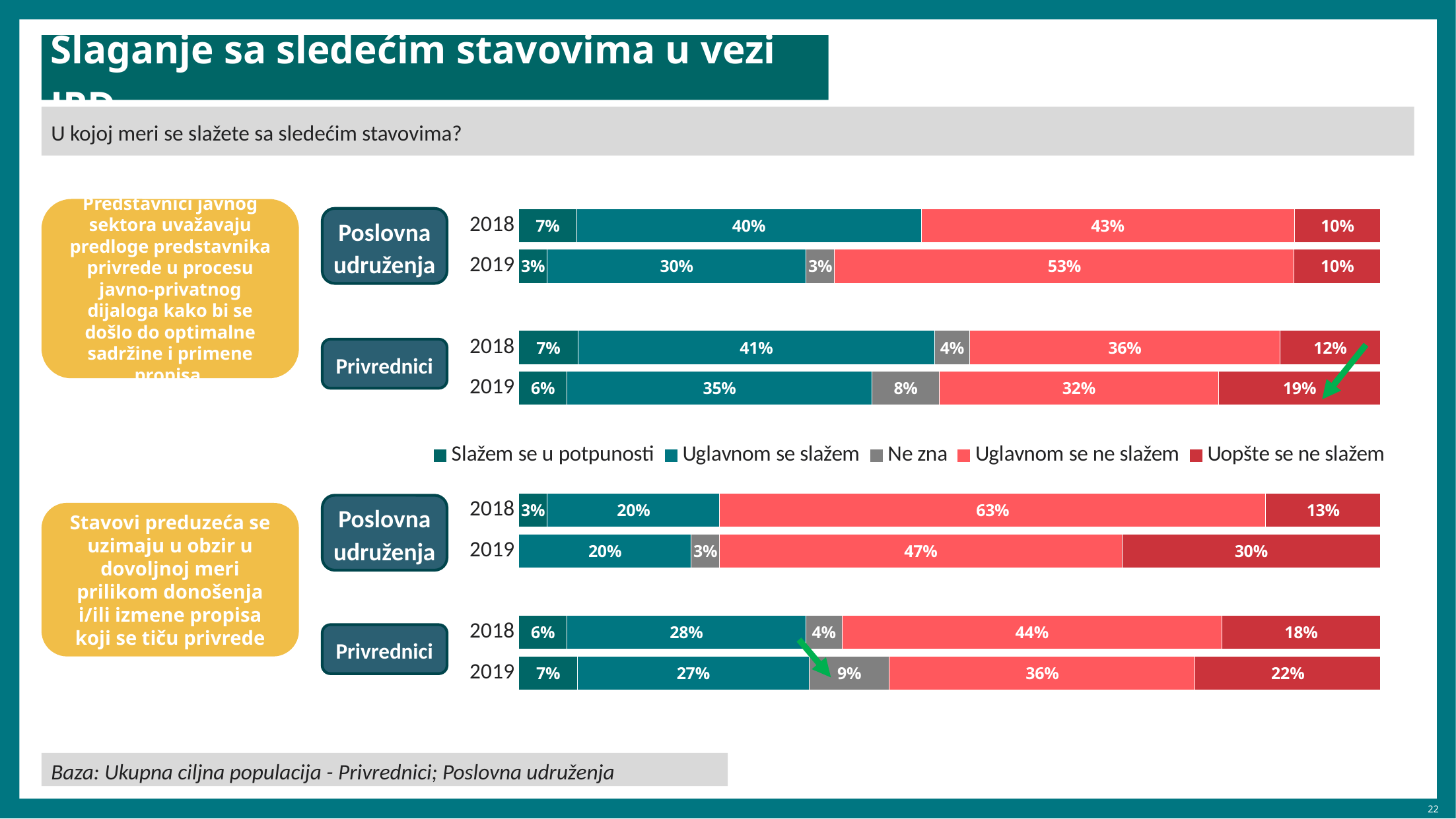
In the bottom chart (Stavovi preduzeća...), what percentage of Poslovna udruženja in 2019 answered 'Uopšte se ne slažem'? 30% In the bottom chart (Stavovi preduzeća...), which year had the larger 'Uopšte se ne slažem' share for Poslovna udruženja, 2018 or 2019? 2019 In the top chart (Predstavnici javnog sektora...), by how many percentage points did the 'Uopšte se ne slažem' share for Privrednici change from 2018 to 2019? 7 percentage points In the bottom chart (Stavovi preduzeća...), what percentage of Privrednici in 2019 answered 'Ne zna'? 9% How many bars are shown in the top chart (Predstavnici javnog sektora...)? 4 In the bottom chart (Stavovi preduzeća...), what percentage of Poslovna udruženja in 2018 answered 'Uglavnom se ne slažem'? 63% In the top chart (Predstavnici javnog sektora...), what percentage of Poslovna udruženja in 2019 answered 'Uglavnom se ne slažem'? 53% What type of chart is used on this slide? Stacked bar chart In the bottom chart (Stavovi preduzeća...), which response category has the largest share for Privrednici in 2018? Uglavnom se ne slažem In the top chart (Predstavnici javnog sektora...), what percentage of Privrednici in 2019 answered 'Uopšte se ne slažem'? 19% In the bottom chart (Stavovi preduzeća...), what is the difference between the 'Uglavnom se ne slažem' share for Poslovna udruženja in 2018 and in 2019? 16 percentage points How many response categories does the legend list? 5